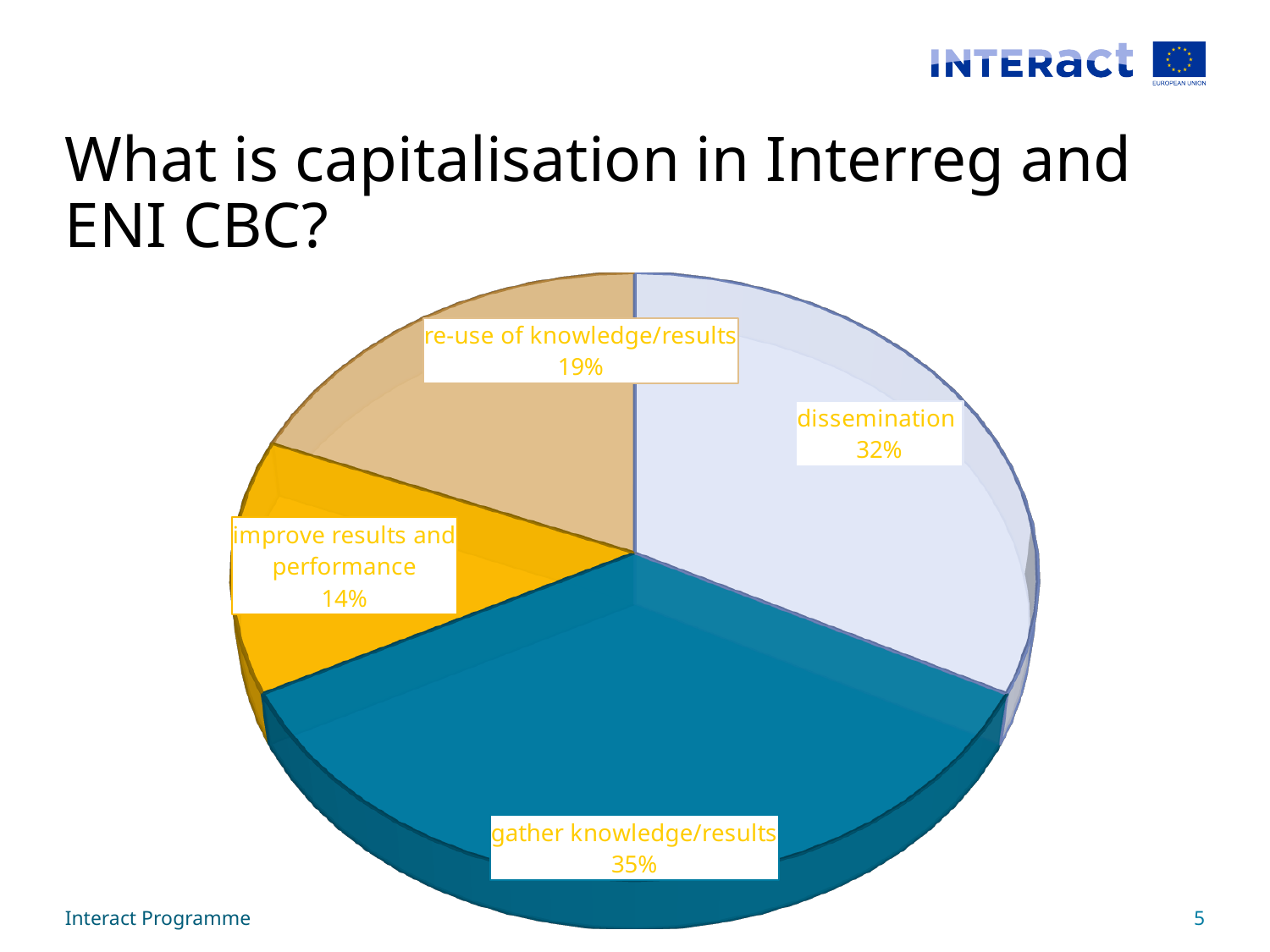
How many slices does the pie chart have? 4 What share of the pie does "improve results and performance" have? 14% Which slice of the pie is the largest? gather knowledge/results What colour is the "gather knowledge/results" slice? teal blue What is the difference in percentage points between "gather knowledge/results" and "dissemination"? 3 percentage points What share of the pie does "gather knowledge/results" have? 35% Which is larger, the share for "dissemination" or the share for "re-use of knowledge/results"? dissemination Which slice of the pie is the smallest? improve results and performance What share of the pie does "dissemination" have? 32% What is the difference in percentage points between "re-use of knowledge/results" and "improve results and performance"? 5 percentage points What share of the pie does "re-use of knowledge/results" have? 19% What kind of chart is shown on the slide? pie chart